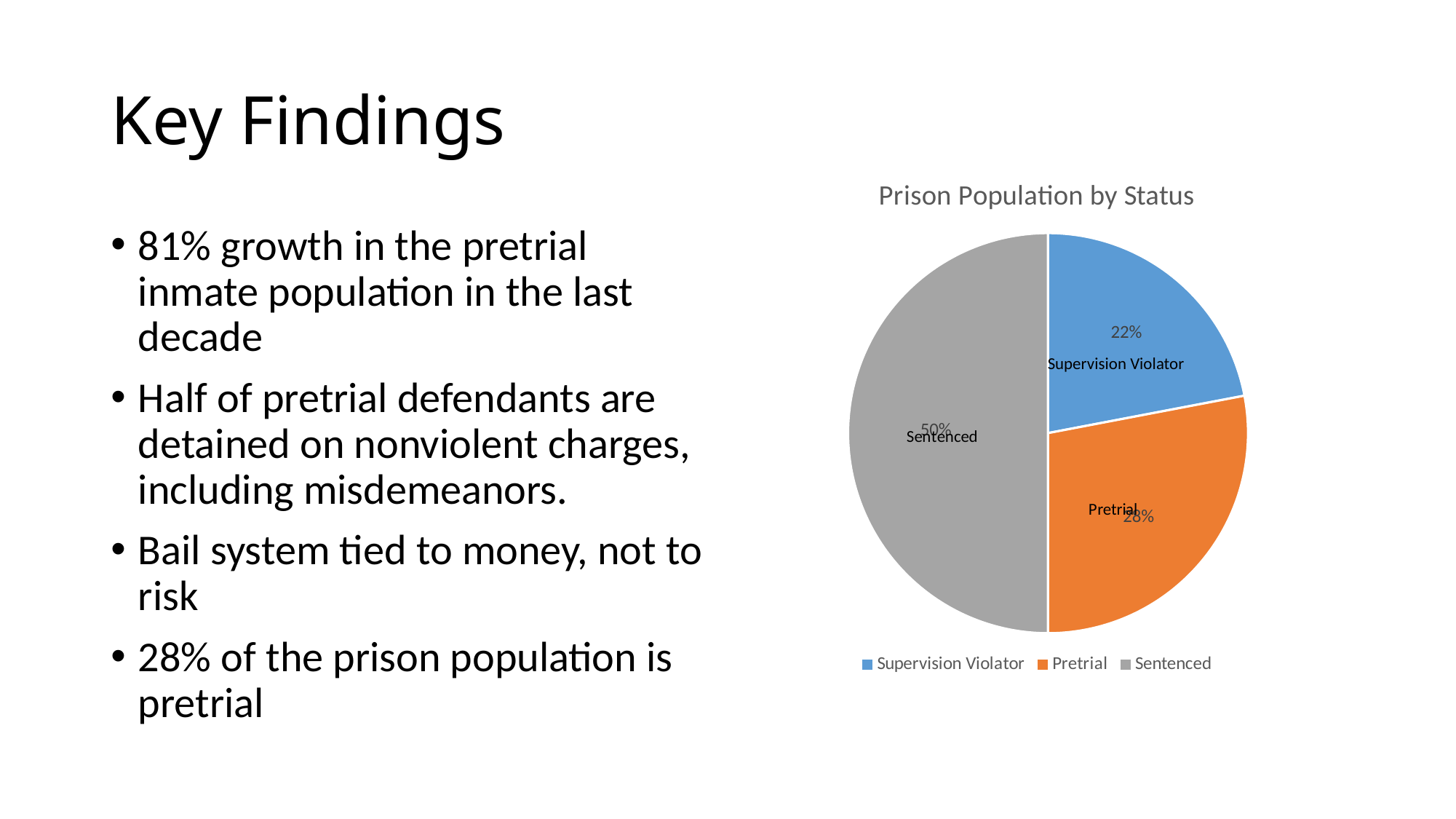
What percentage of the prison population is Pretrial according to the chart? 28% How many entries does the legend list? 3 Which status has the largest share of the prison population? Sentenced What percentage of the prison population is Sentenced? 50% Which status has the smallest share of the prison population? Supervision Violator What type of chart is shown on the slide? Pie chart How many categories does the pie chart show? 3 What percentage of the prison population is Supervision Violator? 22% What colour represents the Sentenced slice? Gray What is the title of the chart? Prison Population by Status What is the difference in percentage points between the Sentenced and Pretrial shares? 22 Which is larger, the Pretrial share or the Supervision Violator share? Pretrial